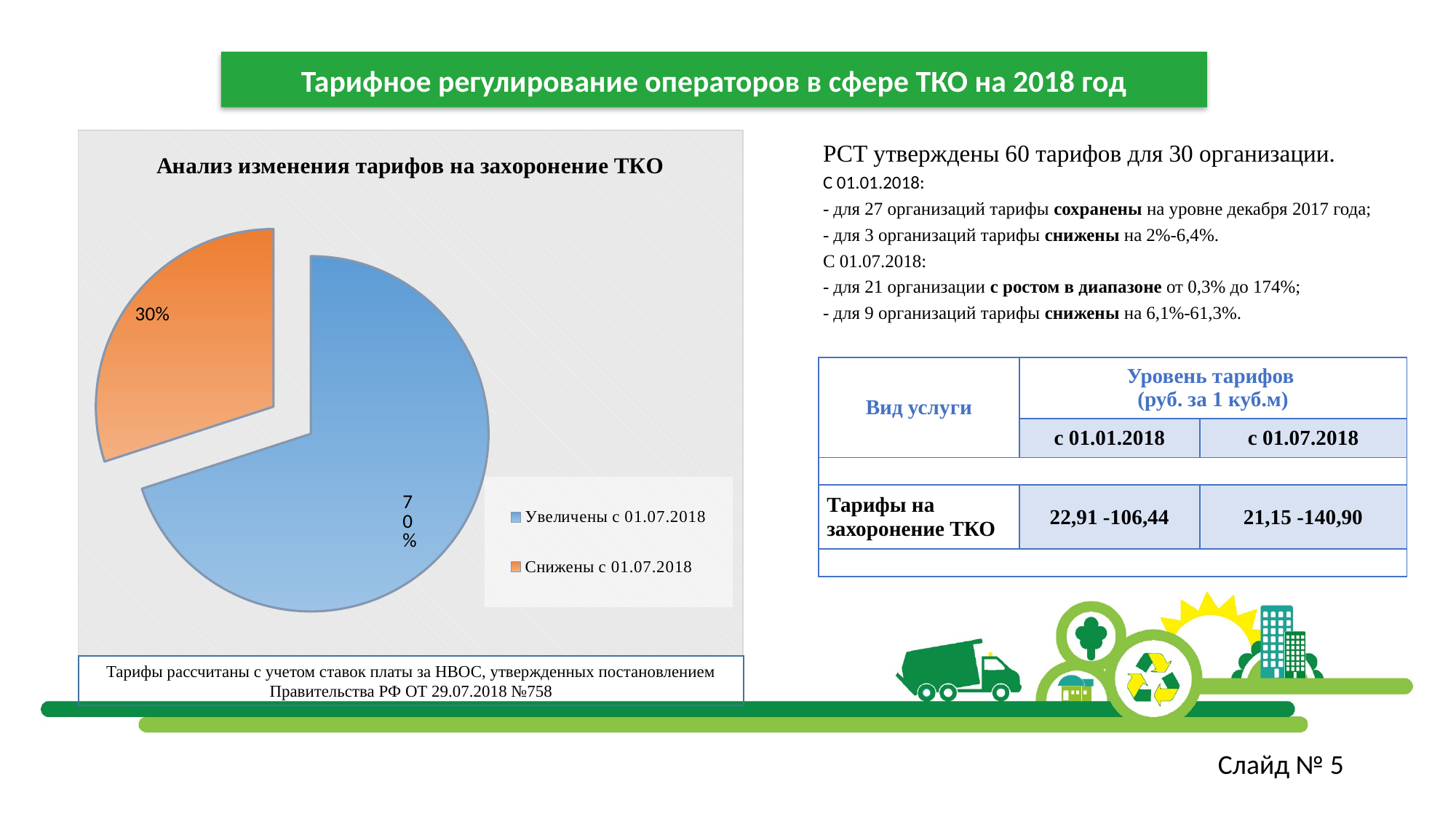
Which slice is the smallest in the pie chart? Снижены с 01.07.2018 How many slices does the pie chart have? 2 What colour is the "Снижены с 01.07.2018" slice in the pie chart? orange What share of the pie is labelled "Снижены с 01.07.2018"? 30% Which slice is the largest in the pie chart? Увеличены с 01.07.2018 By how many percentage points does the "Увеличены с 01.07.2018" slice exceed the "Снижены с 01.07.2018" slice? 40 What share of the pie is labelled "Увеличены с 01.07.2018"? 70% Is the share for "Снижены с 01.07.2018" greater or less than 50%? less Which is larger: the "Увеличены с 01.07.2018" slice or the "Снижены с 01.07.2018" slice? Увеличены с 01.07.2018 How many entries does the chart legend list? 2 What kind of chart is shown on the slide? pie chart What is the title of the chart? Анализ изменения тарифов на захоронение ТКО